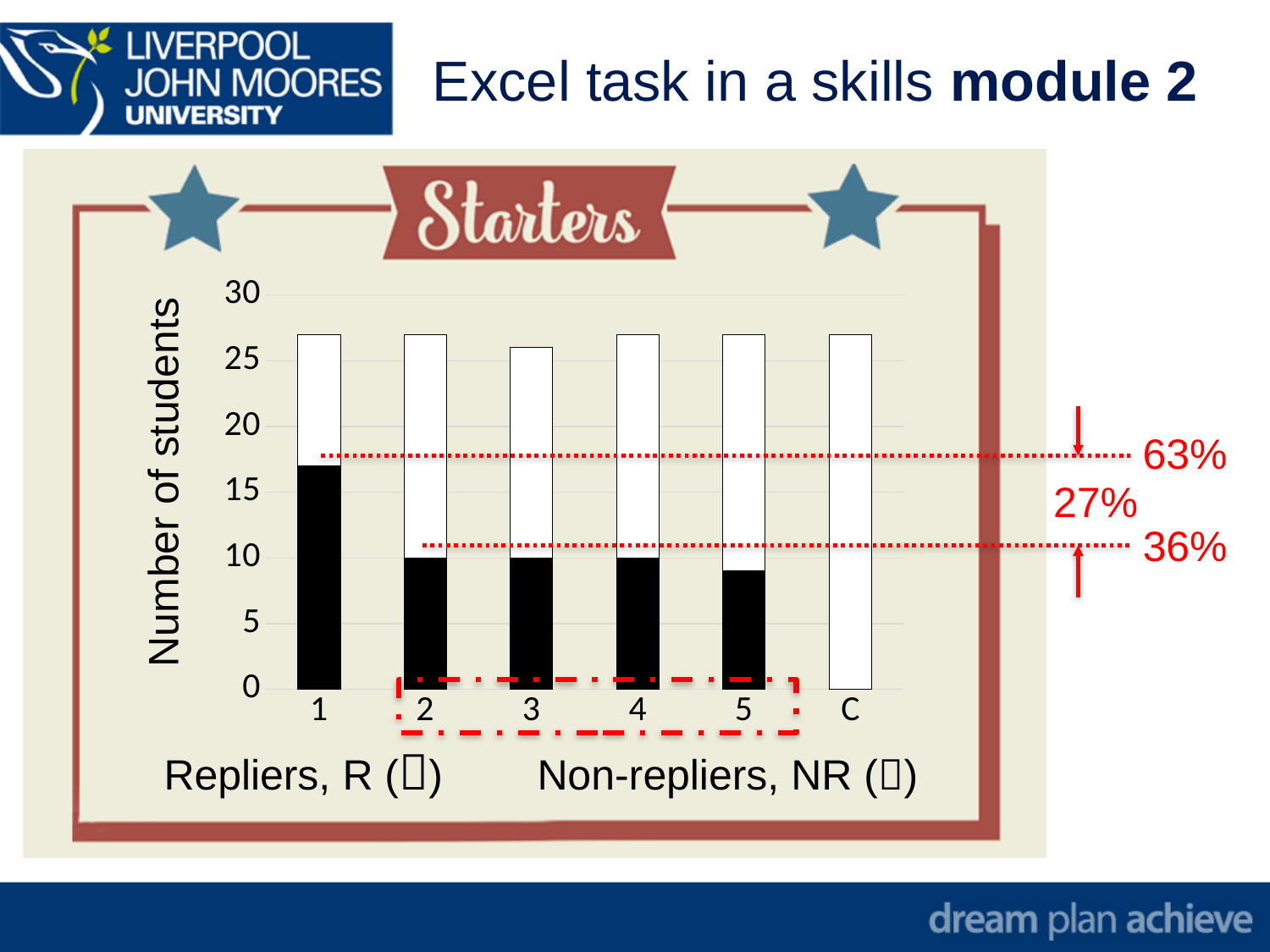
Is the total number of students for category 1 greater or less than 30? less What is the difference between the two percentages annotated in red on the right of the chart (63% and 36%)? 27% Which category has the smallest number of Repliers (black portion)? C Is the number of Repliers for category 1 greater or less than 15? greater How many categories are shown along the x axis of the chart? 6 What is the label of the y axis of the chart? Number of students Which category has the largest number of Repliers (black portion)? 1 What kind of chart is shown on the slide? bar chart Which category has more Repliers, category 1 or category 5? 1 Is the total number of students for category C greater or less than 25? greater